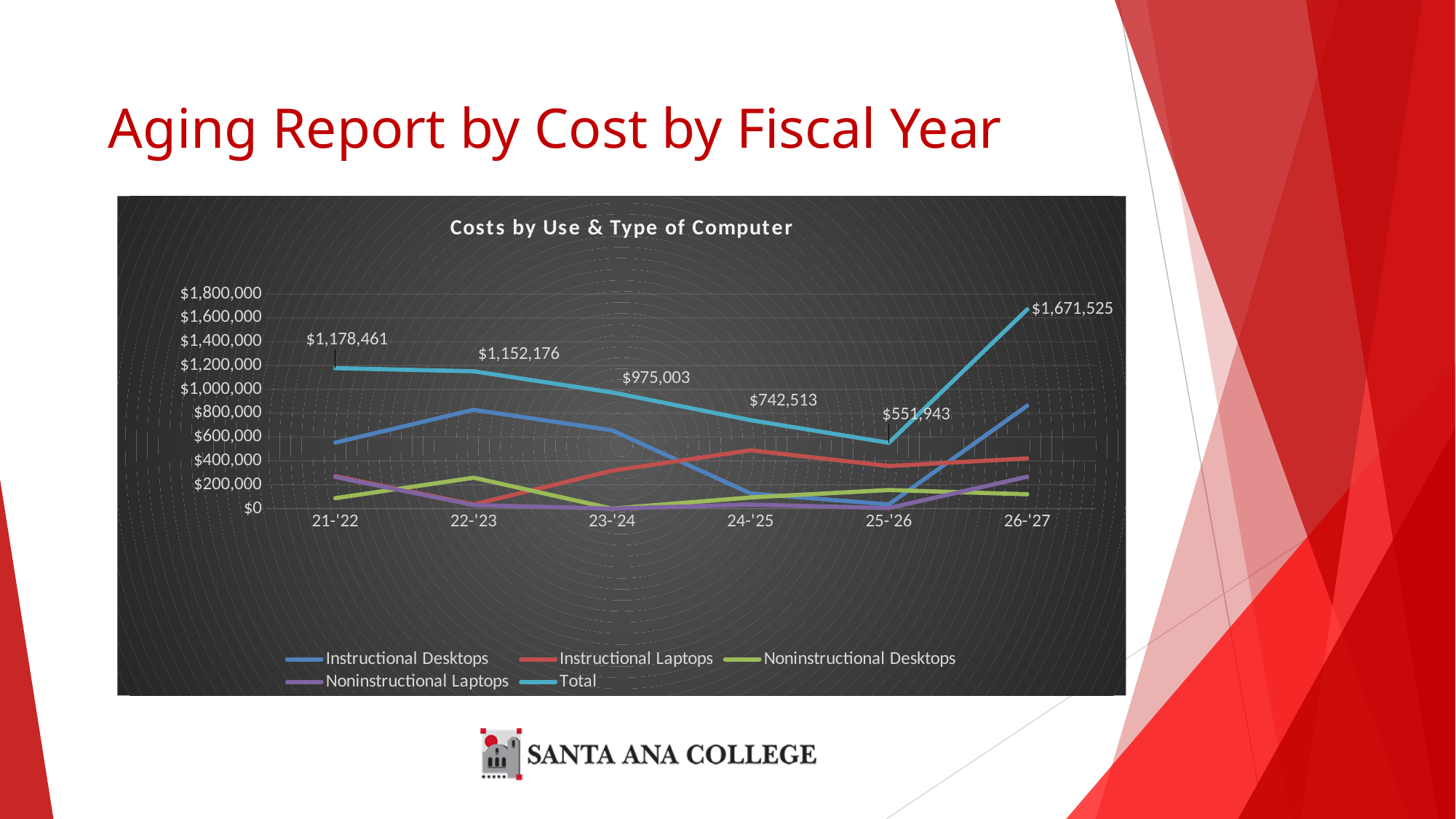
Is the value for Instructional Desktops in 22-'23 greater or less than $600,000? greater Which is larger, the Total for 23-'24 or the Total for 24-'25? 23-'24 In which fiscal year is the Total lowest? 25-'26 What is the difference between the Total for 26-'27 and the Total for 25-'26? $1,119,582 How many series does the legend list? 5 What type of chart is shown on the slide? Line chart What is the title of the chart? Costs by Use & Type of Computer In which fiscal year is the Total highest? 26-'27 What is the Total value for 24-'25? $742,513 Does the Total rise or fall from 21-'22 to 25-'26? Fall What is the Total value for 21-'22? $1,178,461 How many fiscal years are shown on the x axis? 6